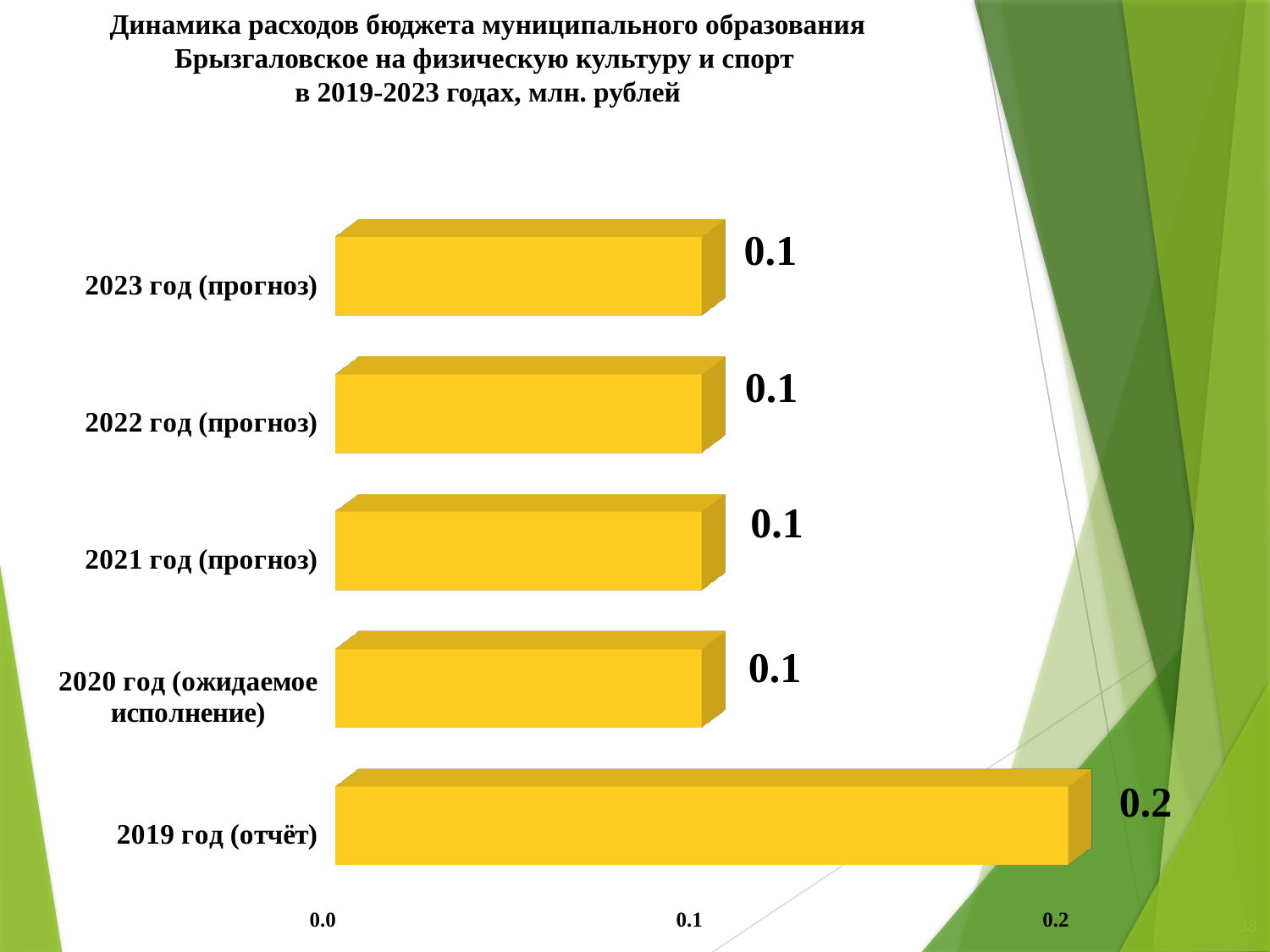
What is the value for 2020 год (ожидаемое исполнение)? 0.1 What is the value for 2021 год (прогноз)? 0.1 Which is larger, the value for 2019 год (отчёт) or the value for 2020 год (ожидаемое исполнение)? 2019 год (отчёт) What is the difference between the values for 2019 год (отчёт) and 2022 год (прогноз)? 0.1 What colour are the bars in the chart? Yellow What is the value for 2023 год (прогноз)? 0.1 Does the value fall or rise from 2019 год (отчёт) to 2020 год (ожидаемое исполнение)? Fall How many categories (years) are shown in the chart? 5 What kind of chart is shown on the slide? Bar chart In what units are the values in the chart expressed, according to the title? млн. рублей Which year has the highest value? 2019 год (отчёт) What is the value for 2019 год (отчёт)? 0.2